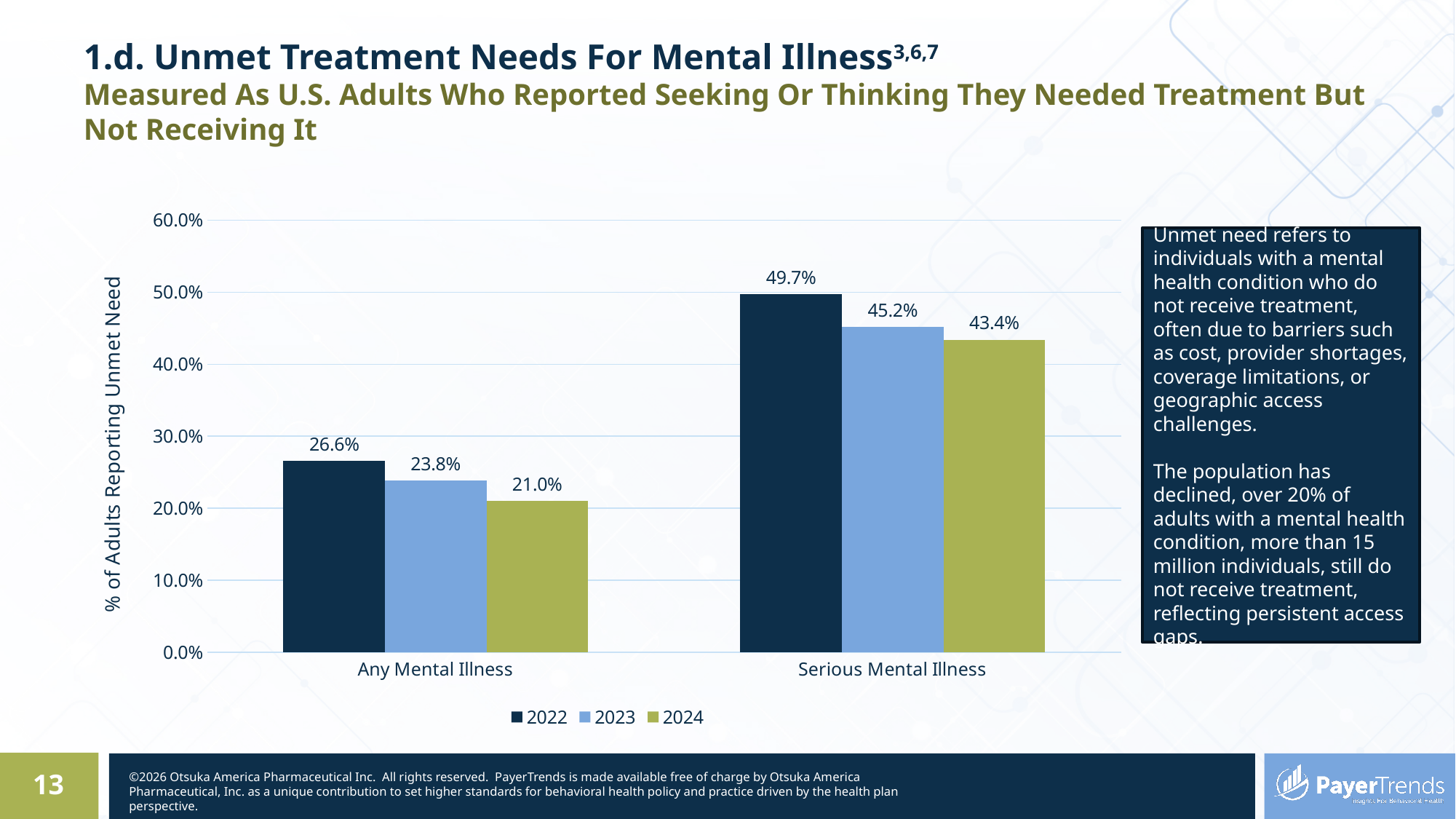
Which is larger: the 2023 value for Any Mental Illness or the 2024 value for Serious Mental Illness? 2024 value for Serious Mental Illness What is the value for Any Mental Illness in 2022? 26.6% How many series does the legend list? 3 What is the value for Serious Mental Illness in 2023? 45.2% Which category has the highest value in 2022? Serious Mental Illness What is the difference between the 2022 and 2023 values for Any Mental Illness? 2.8% Which year has the lowest value for Any Mental Illness? 2024 What kind of chart is shown on the slide? Bar chart Is the 2022 value for Serious Mental Illness greater or less than 50.0%? less What is the value for Serious Mental Illness in 2024? 43.4% What is the difference between the 2022 and 2024 values for Serious Mental Illness? 6.3% Do the values for Serious Mental Illness rise or fall from 2022 to 2024? Fall